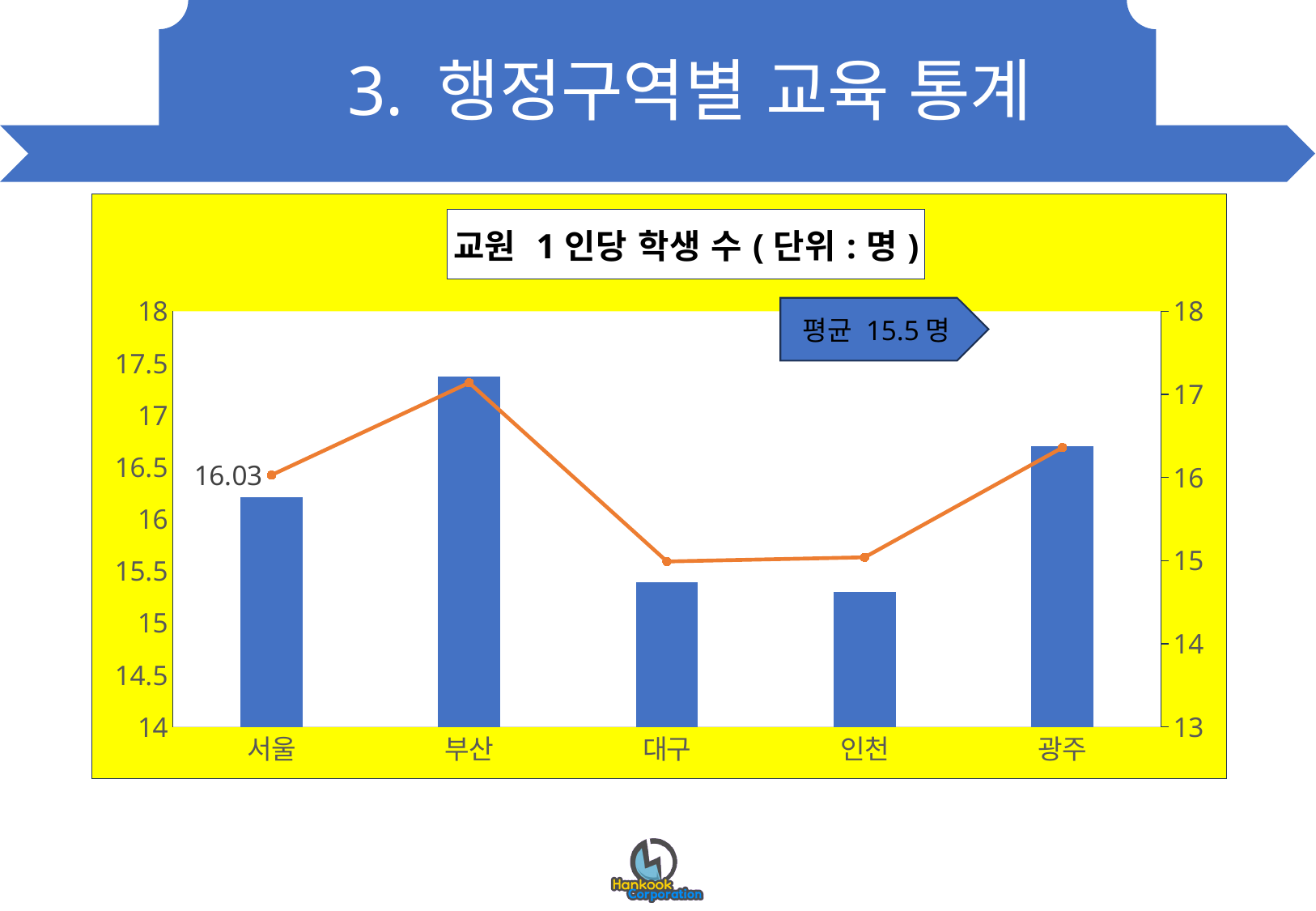
Which category has the highest point on the line? 부산 Is the bar for 광주 greater or less than 16 on the left axis? greater Is the bar for 부산 greater or less than 17 on the left axis? greater What is the title of the chart? 교원 1인당 학생 수 (단위 : 명) How many categories are shown on the x axis? 5 What average value is shown in the callout on the chart? 평균 15.5 명 Which category has the tallest bar? 부산 Which bar is taller, 서울 or 광주? 광주 What kind of chart is this? A bar chart combined with a line What is the data label shown on the line for 서울? 16.03 Is the bar for 대구 greater or less than 16 on the left axis? less Which bar is taller, 부산 or 광주? 부산